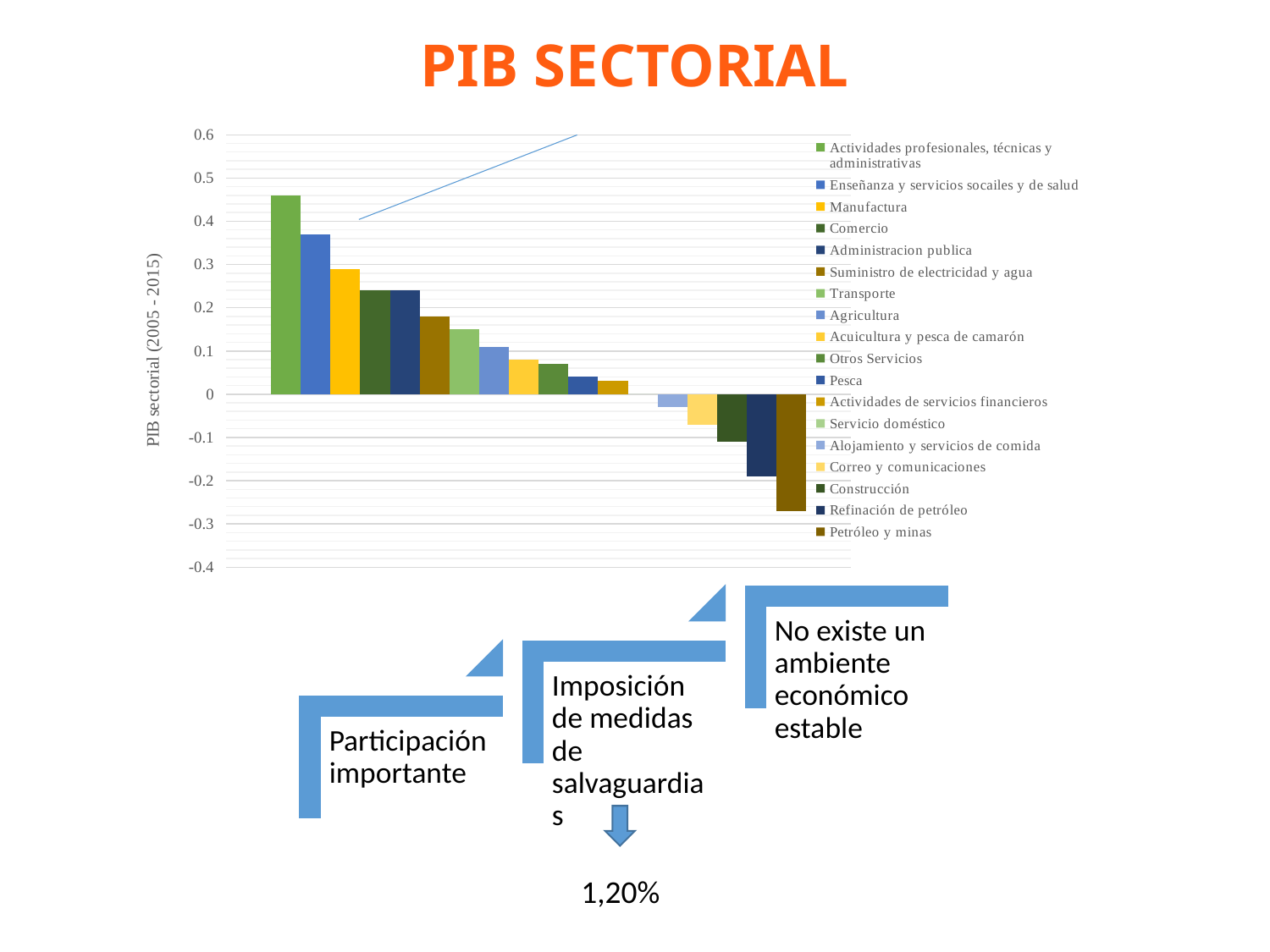
Is the value for Petróleo y minas greater or less than -0.2? less Is the value for Refinación de petróleo greater or less than -0.1? less What is the label on the vertical axis of the chart? PIB sectorial (2005 - 2015) Which sector has the lowest value in the chart? Petróleo y minas Which sector has the highest value in the chart? Actividades profesionales, técnicas y administrativas Which is larger, the value for Construcción or the value for Refinación de petróleo? Construcción Is the value for Enseñanza y servicios socailes y de salud greater or less than 0.3? greater How many series does the chart legend list? 18 What kind of chart is shown on the slide? Bar chart Which is larger, the value for Enseñanza y servicios socailes y de salud or the value for Manufactura? Enseñanza y servicios socailes y de salud